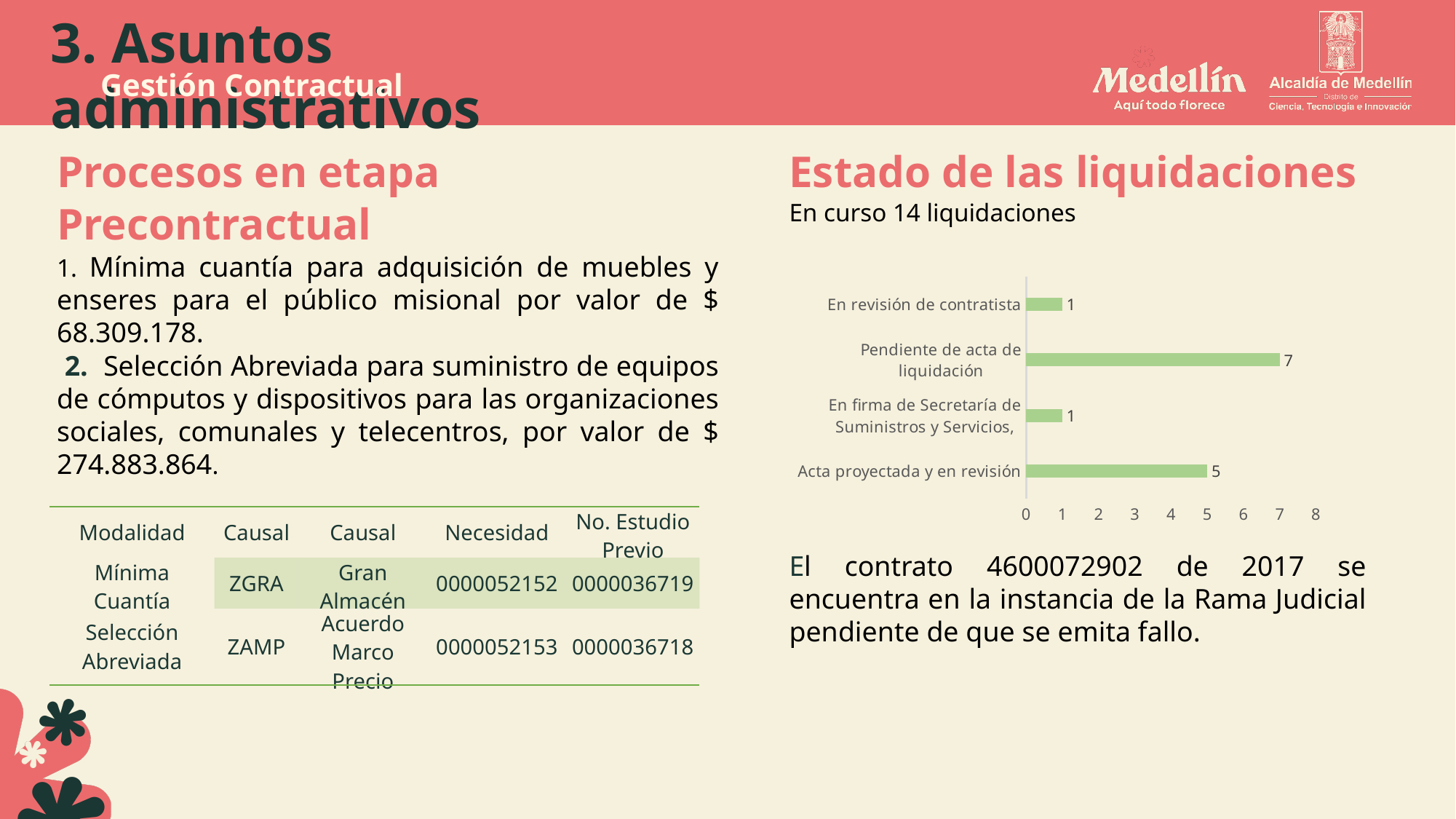
How many categories are shown in the chart? 4 Is the value for 'Pendiente de acta de liquidación' greater or less than 6? greater What is the value for 'Acta proyectada y en revisión'? 5 What is the value for 'Pendiente de acta de liquidación'? 7 Which category has the highest value? Pendiente de acta de liquidación What is the value for 'En firma de Secretaría de Suministros y Servicios,'? 1 What is the difference between 'Pendiente de acta de liquidación' and 'Acta proyectada y en revisión'? 2 What is the total of all the values shown in the chart? 14 What kind of chart is shown on the slide? bar chart Which is larger: 'Acta proyectada y en revisión' or 'En revisión de contratista'? Acta proyectada y en revisión What is the value for 'En revisión de contratista'? 1 What is the highest value shown on the chart's x axis? 8